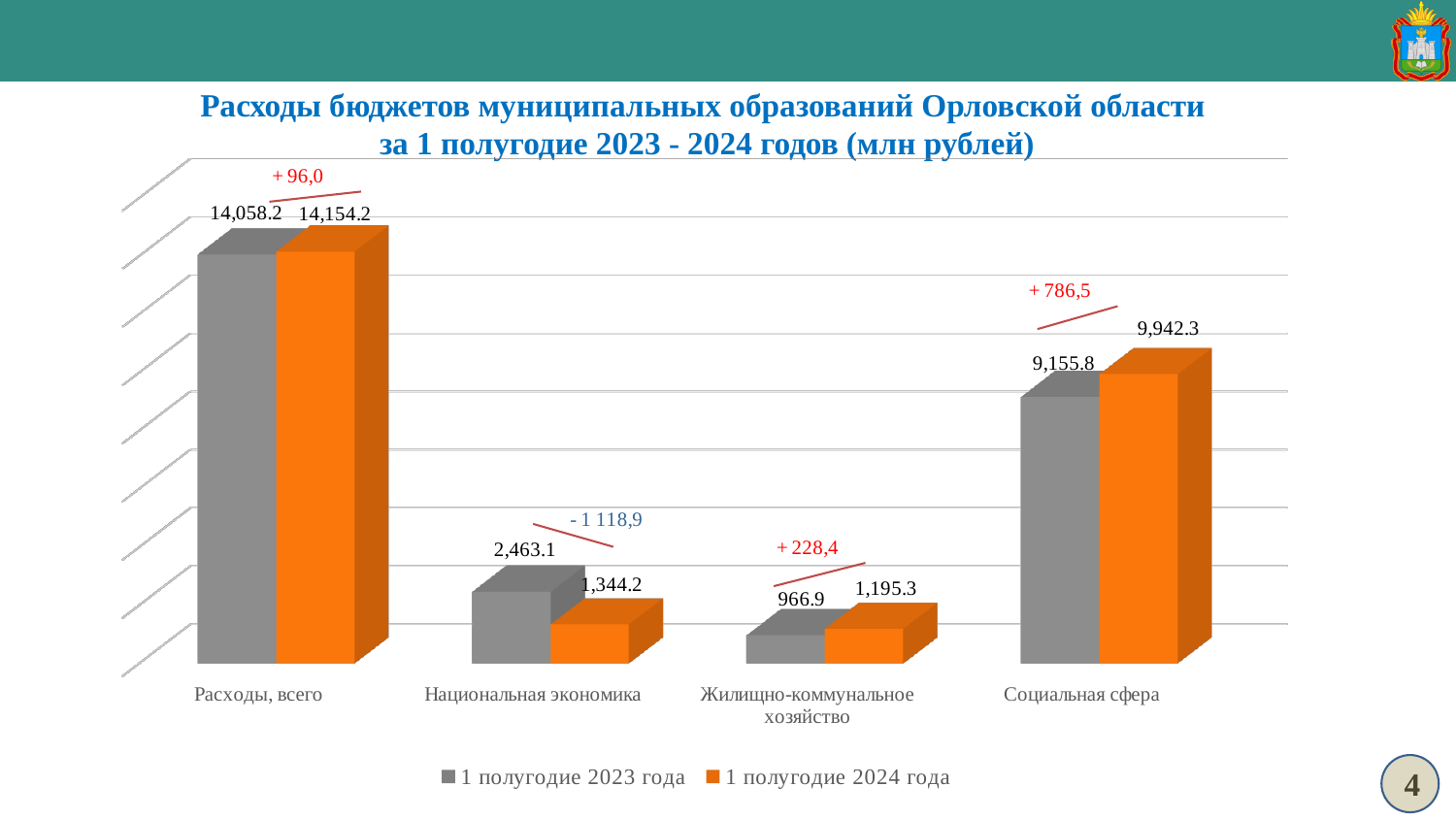
What is the difference between the 1 полугодие 2024 года and 1 полугодие 2023 года values for Социальная сфера? 786.5 Which is larger for Национальная экономика: the 1 полугодие 2023 года value or the 1 полугодие 2024 года value? 1 полугодие 2023 года What is the value for Национальная экономика in the 1 полугодие 2023 года series? 2,463.1 Which category has the highest value in the 1 полугодие 2024 года series? Расходы, всего What is the value for Расходы, всего in the 1 полугодие 2024 года series? 14,154.2 How many categories are shown on the x axis? 4 How many series does the legend list? 2 What is the value for Жилищно-коммунальное хозяйство in the 1 полугодие 2024 года series? 1,195.3 Which category has the lowest value in the 1 полугодие 2023 года series? Жилищно-коммунальное хозяйство What is the value for Социальная сфера in the 1 полугодие 2023 года series? 9,155.8 Which colour represents the 1 полугодие 2024 года series? Orange What kind of chart is shown on the slide? Bar chart